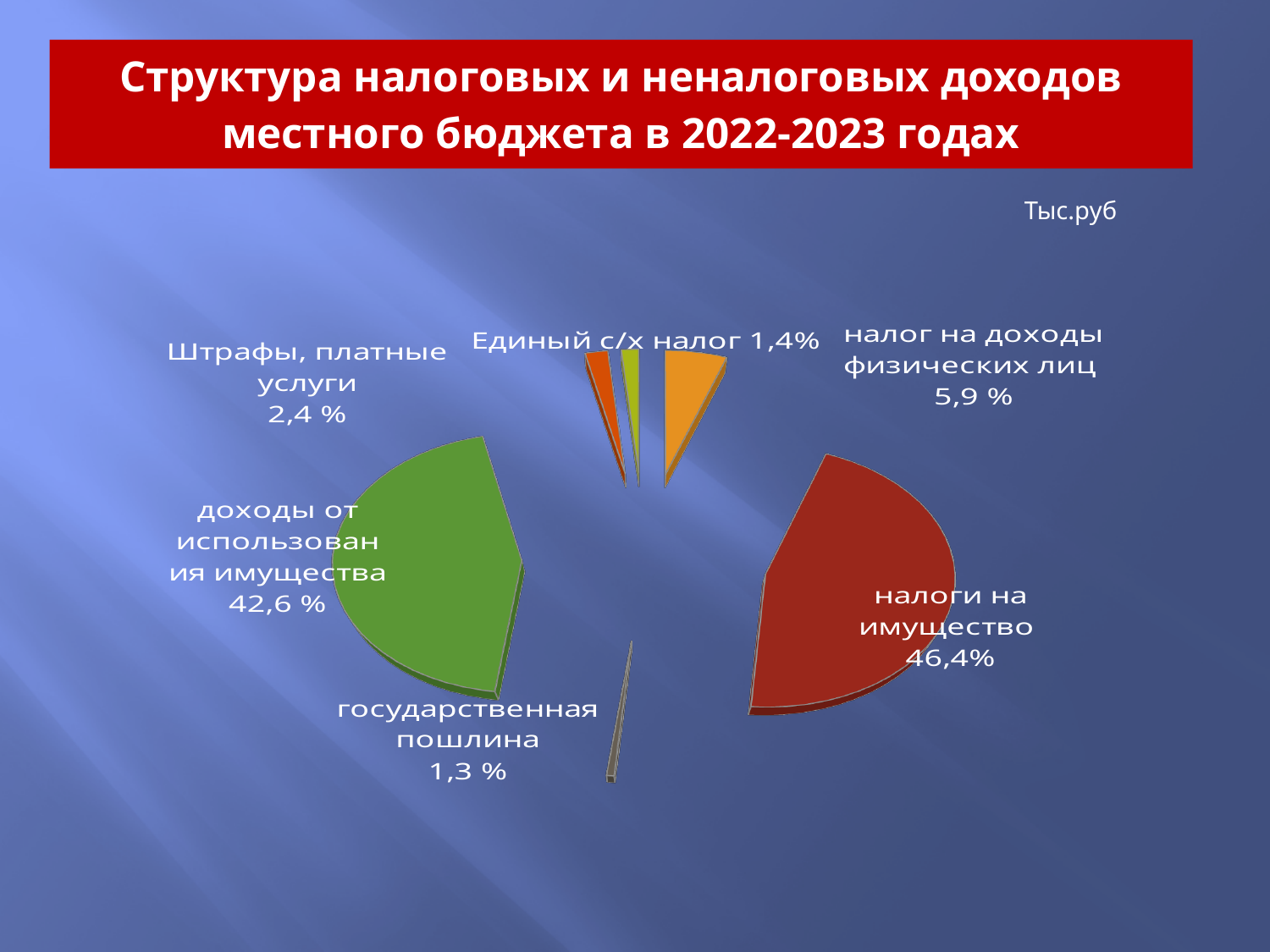
What kind of chart is shown on the slide? pie chart What unit is indicated above the chart? Тыс.руб Which category has the smallest slice of the pie? государственная пошлина What is the value labelled for налог на доходы физических лиц? 5,9 % What share is shown for Штрафы, платные услуги? 2,4 % What is the difference between the shares of налоги на имущество and доходы от использования имущества? 3,8 % What is the value for государственная пошлина? 1,3 % What share of the pie does налоги на имущество hold? 46,4% How many slices does the pie chart have? 6 Which is larger: the share for налог на доходы физических лиц or for Штрафы, платные услуги? налог на доходы физических лиц Which category has the largest slice of the pie? налоги на имущество What share is shown for доходы от использования имущества? 42,6 %